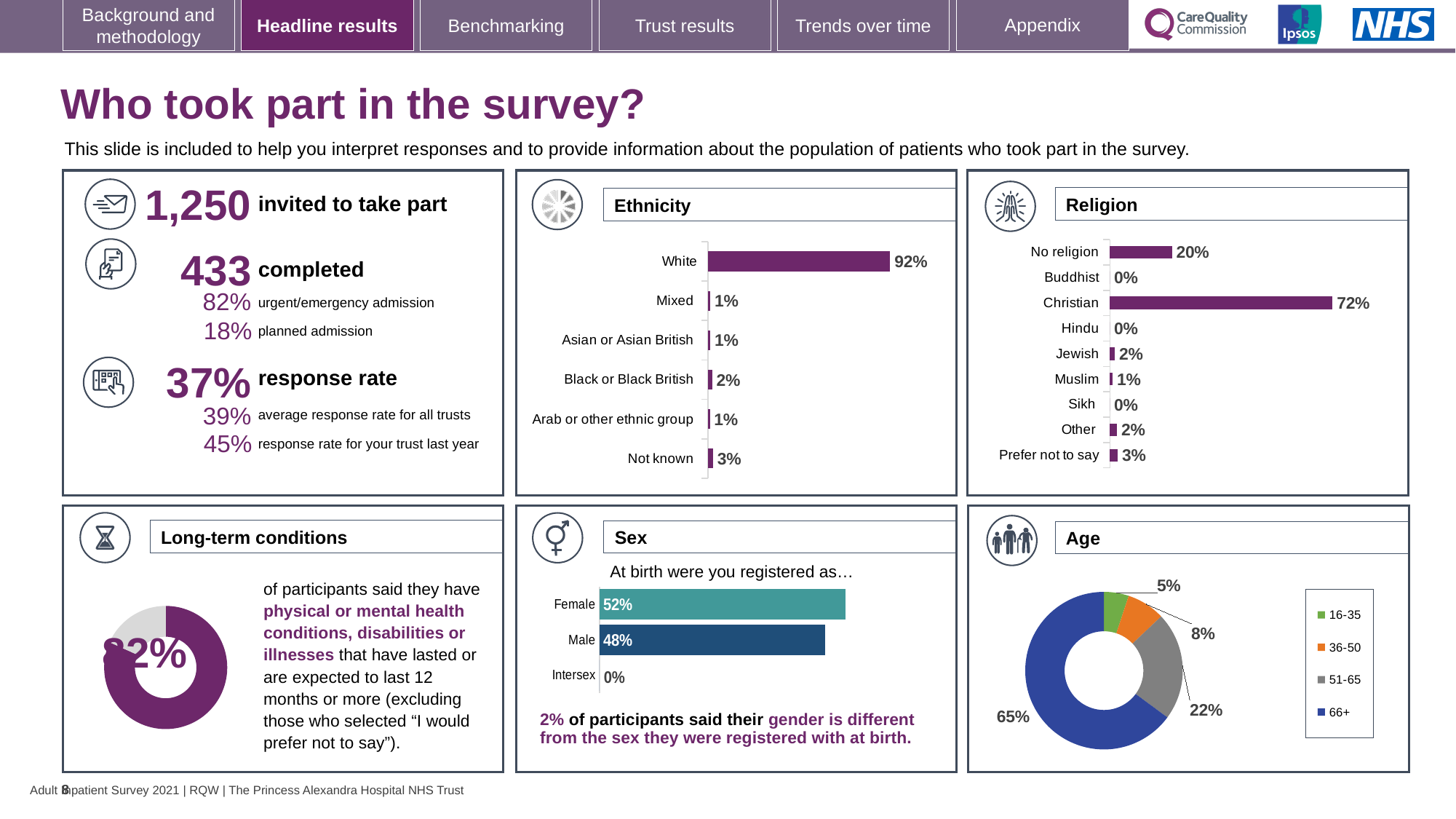
In the Ethnicity chart, which ethnic group has the highest percentage? White In the Ethnicity chart, what percentage of participants were White? 92% In the Sex chart, what is the difference between the Female and Male percentages? 4% In the Sex chart, what percentage of participants were registered as Female at birth? 52% In the Age chart, how many age groups does the legend list? 4 What kind of chart is the Age chart? Doughnut chart In the Religion chart, what is the difference between the Christian and No religion percentages? 52% In the Religion chart, which is larger, the value for Jewish or the value for Muslim? Jewish In the Age chart, what share of participants were aged 66+? 65% In the Religion chart, how many religion categories are listed? 9 In the Religion chart, what percentage of participants were Christian? 72% In the Ethnicity chart, what is the value for Not known? 3%